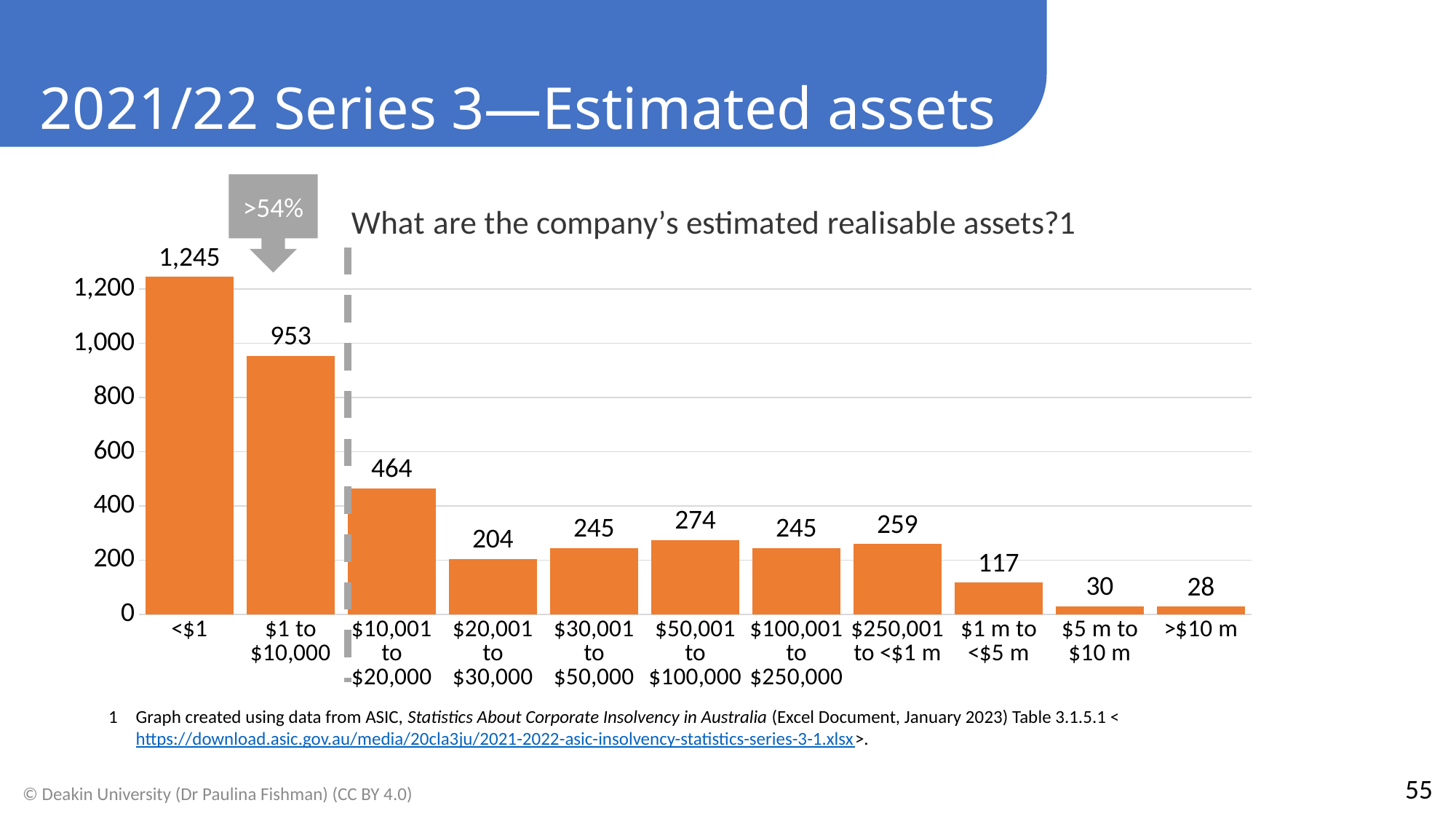
How many categories are shown on the x axis? 11 What is the value for the $10,001 to $20,000 category? 464 What is the value for the $1 m to <$5 m category? 117 What is the value for the <$1 category? 1,245 What percentage is shown in the grey arrow above the first two bars? >54% What is the difference between the values for <$1 and $1 to $10,000? 292 What kind of chart is shown on the slide? Bar chart What question is shown as the chart's title? What are the company's estimated realisable assets? Which is larger, the value for $50,001 to $100,000 or the value for $250,001 to <$1 m? $50,001 to $100,000 Which category has the lowest value? >$10 m Which category has the highest value? <$1 What is the difference between the values for $5 m to $10 m and >$10 m? 2